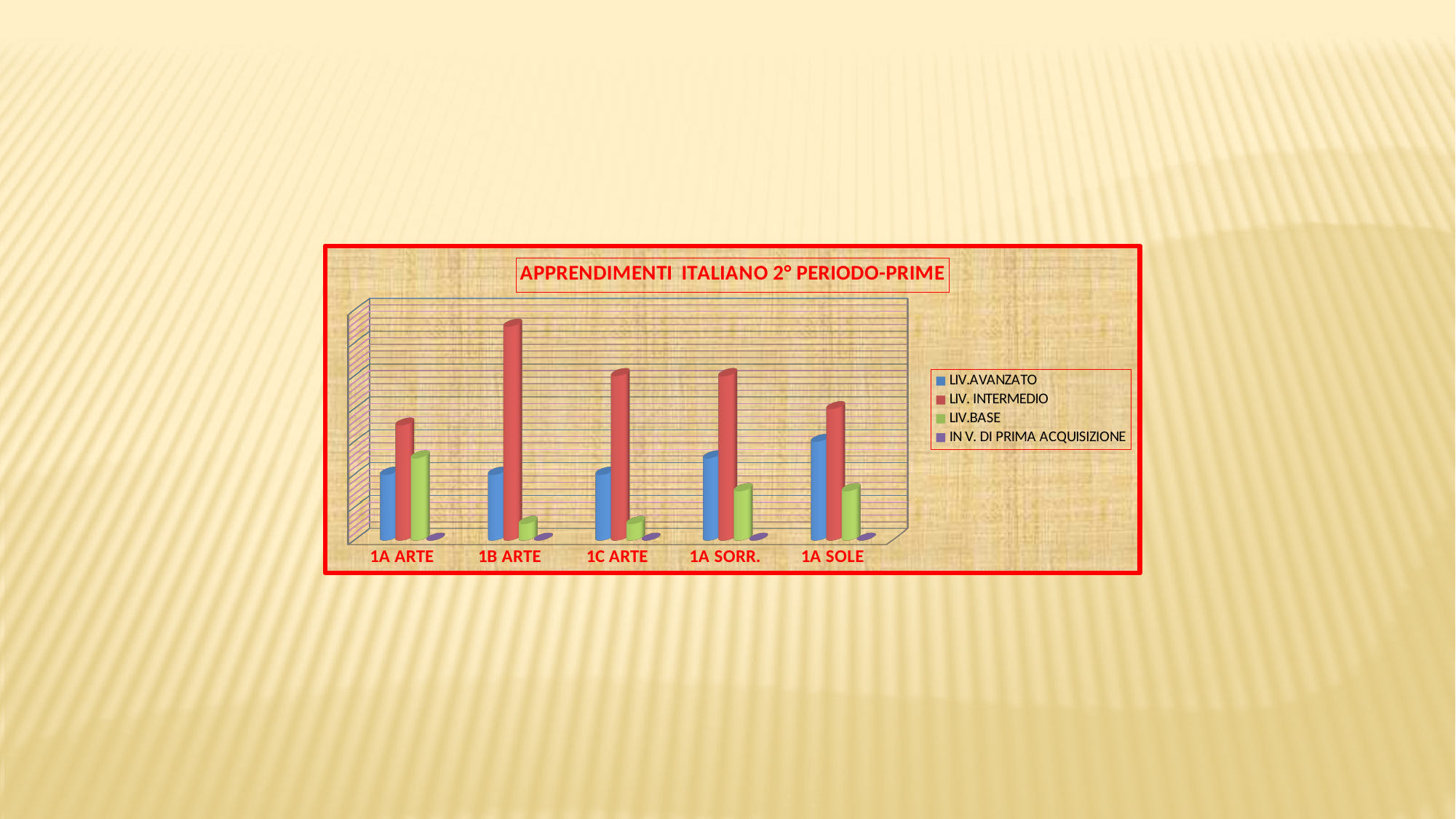
Which class has the highest LIV.AVANZATO bar? 1A SOLE What is the title of the chart? APPRENDIMENTI ITALIANO 2° PERIODO-PRIME In 1A ARTE, which is larger: LIV.AVANZATO or LIV.BASE? LIV.BASE How many series does the legend list? 4 In 1A SOLE, which is larger: LIV.AVANZATO or LIV.BASE? LIV.AVANZATO Which class has the lowest LIV. INTERMEDIO bar? 1A ARTE Which legend entry is shown in purple? IN V. DI PRIMA ACQUISIZIONE How many categories (classes) are shown on the x axis? 5 Which class has the highest LIV. INTERMEDIO bar? 1B ARTE Which class has the highest LIV.BASE bar? 1A ARTE Which series has the tallest bar in every class? LIV. INTERMEDIO What kind of chart is shown on the slide? bar chart